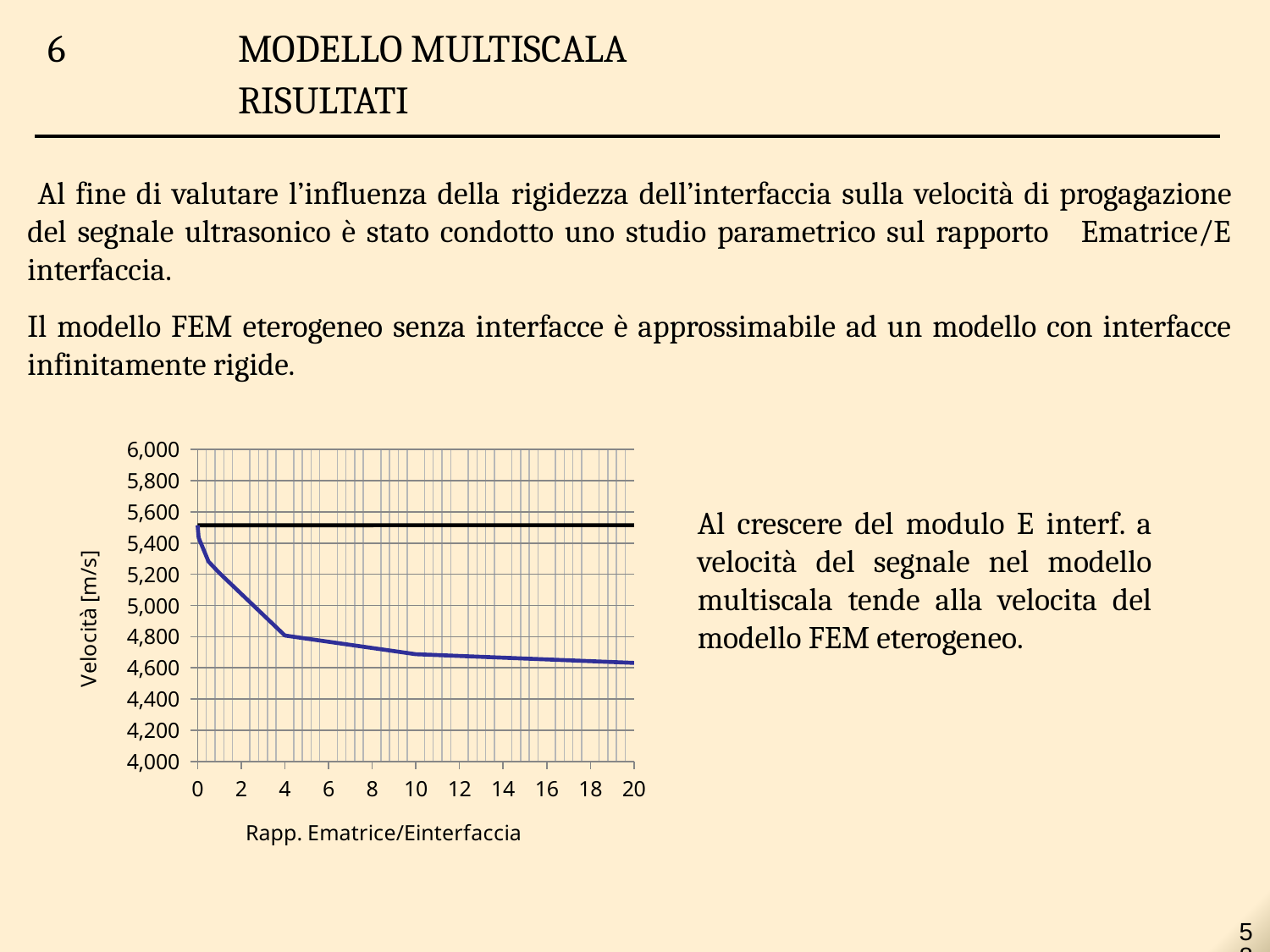
Is the value of the blue line at Rapp. Ematrice/Einterfaccia = 2 greater or less than 5,400? less What is the highest value shown on the vertical axis of the chart? 6,000 Is the value of the blue line at Rapp. Ematrice/Einterfaccia = 20 greater or less than 4,800? less What kind of chart is shown on the slide? line chart How many lines are plotted on the chart? 2 At Rapp. Ematrice/Einterfaccia = 10, which line has the higher velocity, the blue line or the black line? the black line Is the value of the black horizontal line greater or less than 5,600? less What is the label of the horizontal axis of the chart? Rapp. Ematrice/Einterfaccia What is the label of the vertical axis of the chart? Velocità [m/s] Does the blue line rise or fall as the Rapp. Ematrice/Einterfaccia increases from 0 to 20? fall